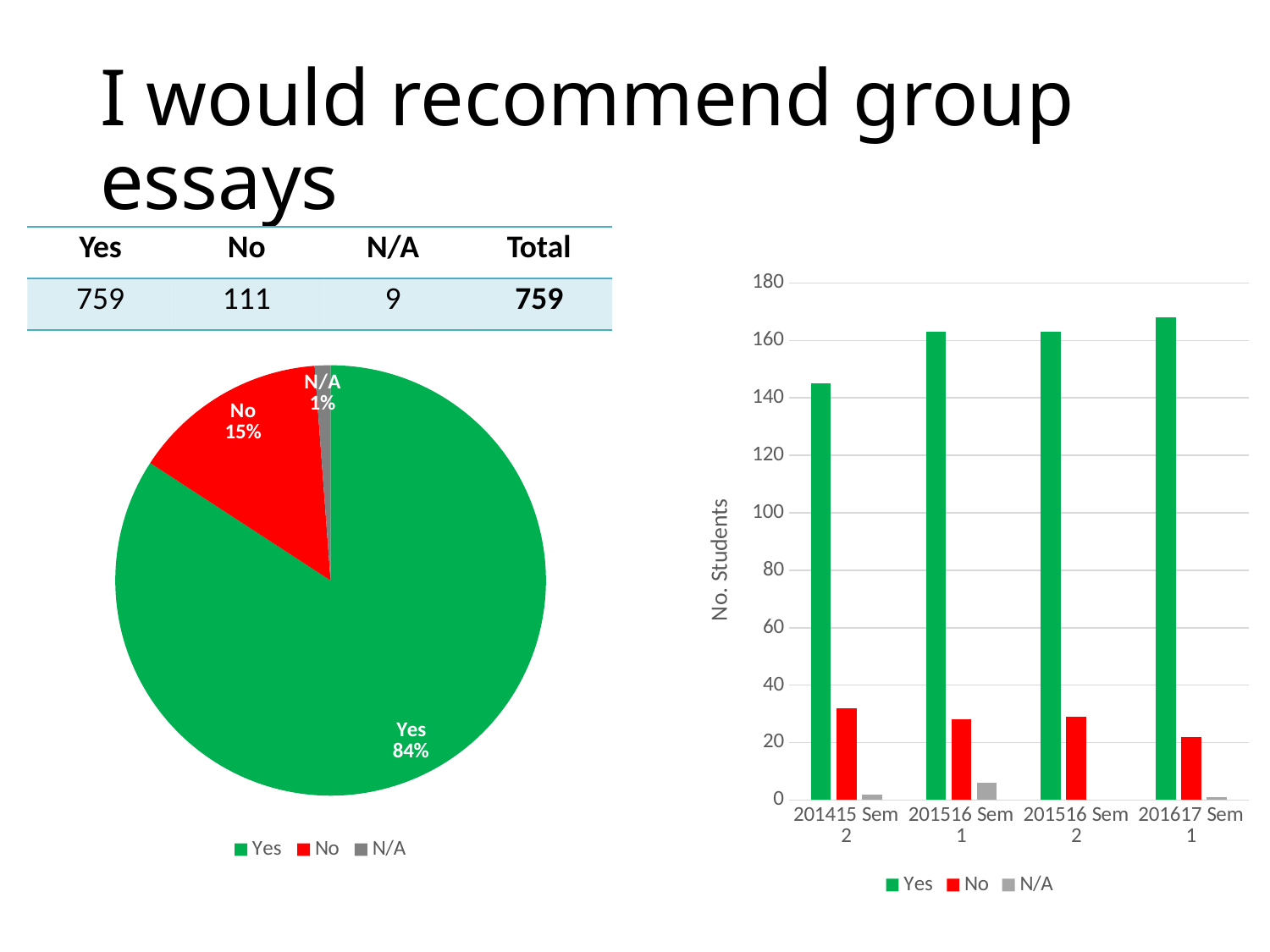
In the pie chart on the left, which slice is the smallest? N/A How many series does the legend of the bar chart on the right list? 3 What kind of chart is on the right side of the slide? Bar chart In the bar chart on the right, what is the label of the vertical axis? No. Students In the bar chart on the right, is the "No" value for 201617 Sem 1 greater or less than 40? less In the pie chart on the left, what share of responses is "Yes"? 84% In the pie chart on the left, what percentage is labelled for "N/A"? 1% How many slices does the pie chart on the left have? 3 In the bar chart on the right, is the "Yes" value for 201415 Sem 2 greater or less than 140? greater In the pie chart on the left, what percentage is labelled for "No"? 15% In the bar chart on the right, which category has the lowest "Yes" value? 201415 Sem 2 In the pie chart on the left, how many percentage points larger is the "Yes" share than the "No" share? 69